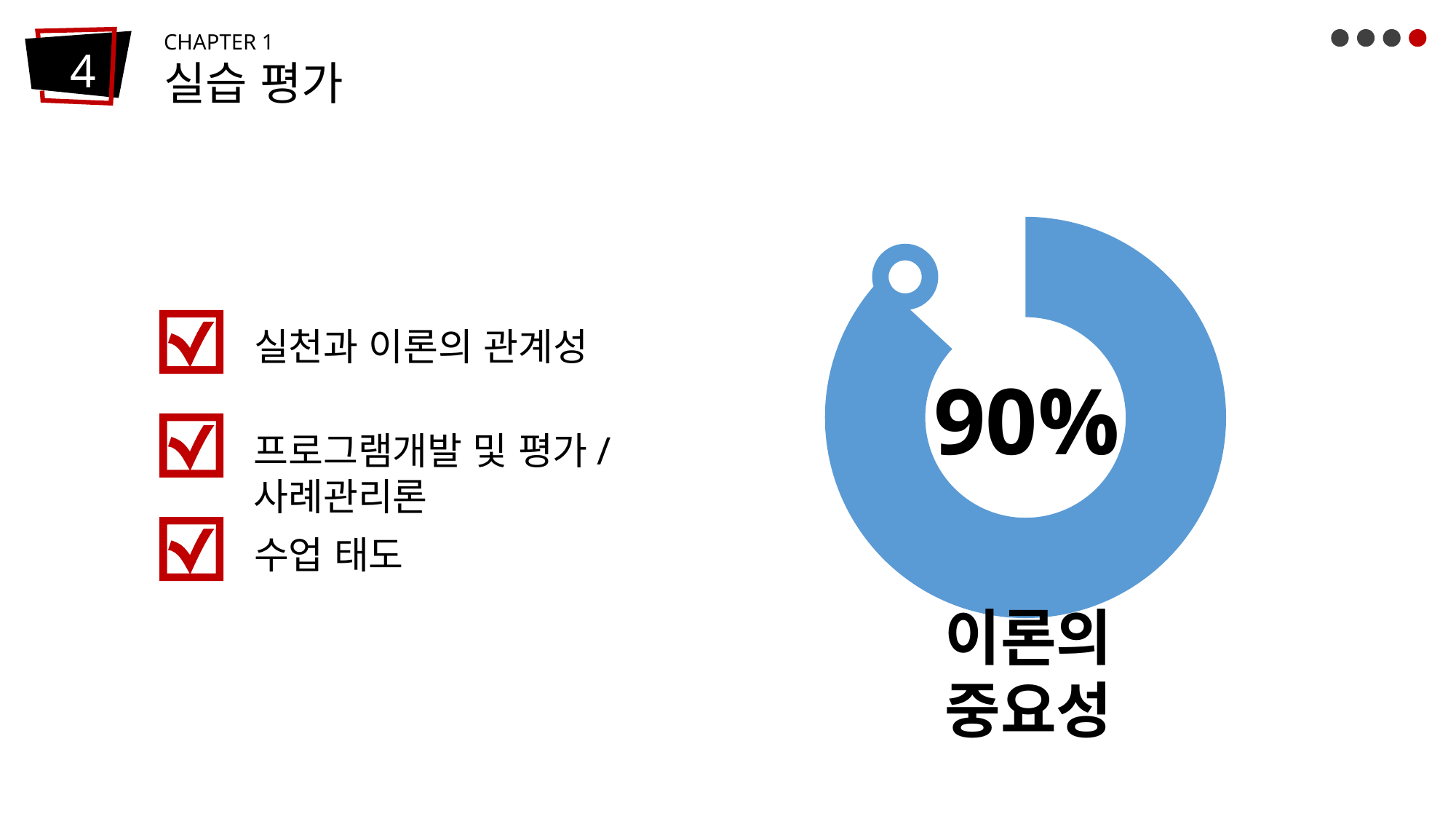
What kind of chart is shown on the right of the slide? donut (pie) chart What label is written beneath the donut chart? 이론의 중요성 How many values are displayed in the donut chart? 1 What colour is the filled portion of the donut chart? blue Is the value shown in the donut chart greater or less than 50%? greater What percentage is printed in the centre of the donut chart? 90%